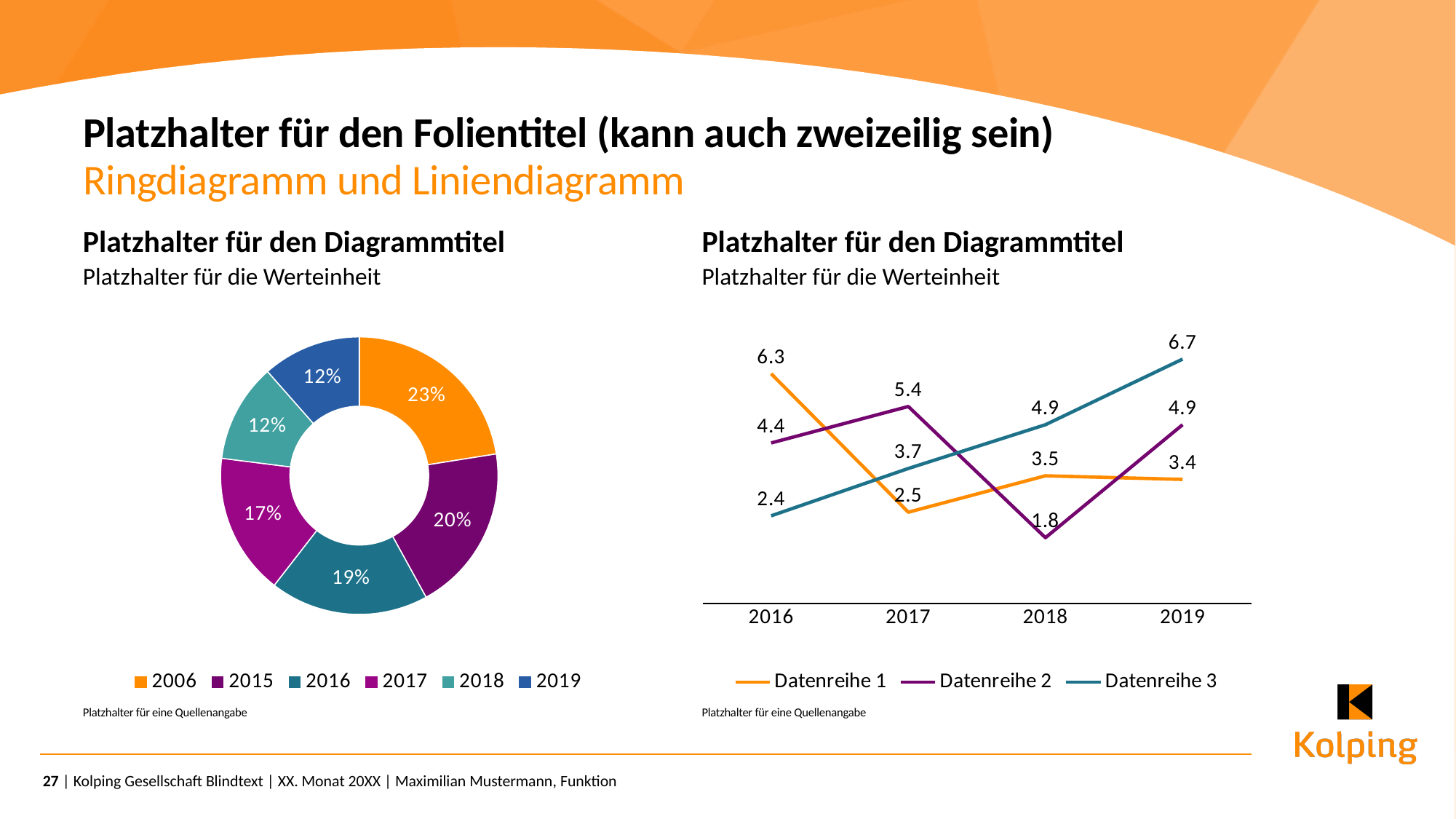
In the doughnut chart on the left, what share does 2006 have? 23% What type of chart is shown on the left side of the slide? Doughnut chart In the line chart on the right, does Datenreihe 3 rise or fall from 2016 to 2019? Rise In the line chart on the right, what is the value of Datenreihe 3 in 2019? 6.7 What type of chart is shown on the right side of the slide? Line chart How many categories does the legend of the doughnut chart on the left list? 6 In the doughnut chart on the left, what is the difference between the shares of 2015 and 2017? 3% In the line chart on the right, what is the value of Datenreihe 2 in 2018? 1.8 In the line chart on the right, which year has the lowest value for Datenreihe 1? 2017 In the line chart on the right, which is larger in 2016: Datenreihe 1 or Datenreihe 2? Datenreihe 1 In the doughnut chart on the left, which category has the largest share? 2006 How many series does the legend of the line chart on the right list? 3